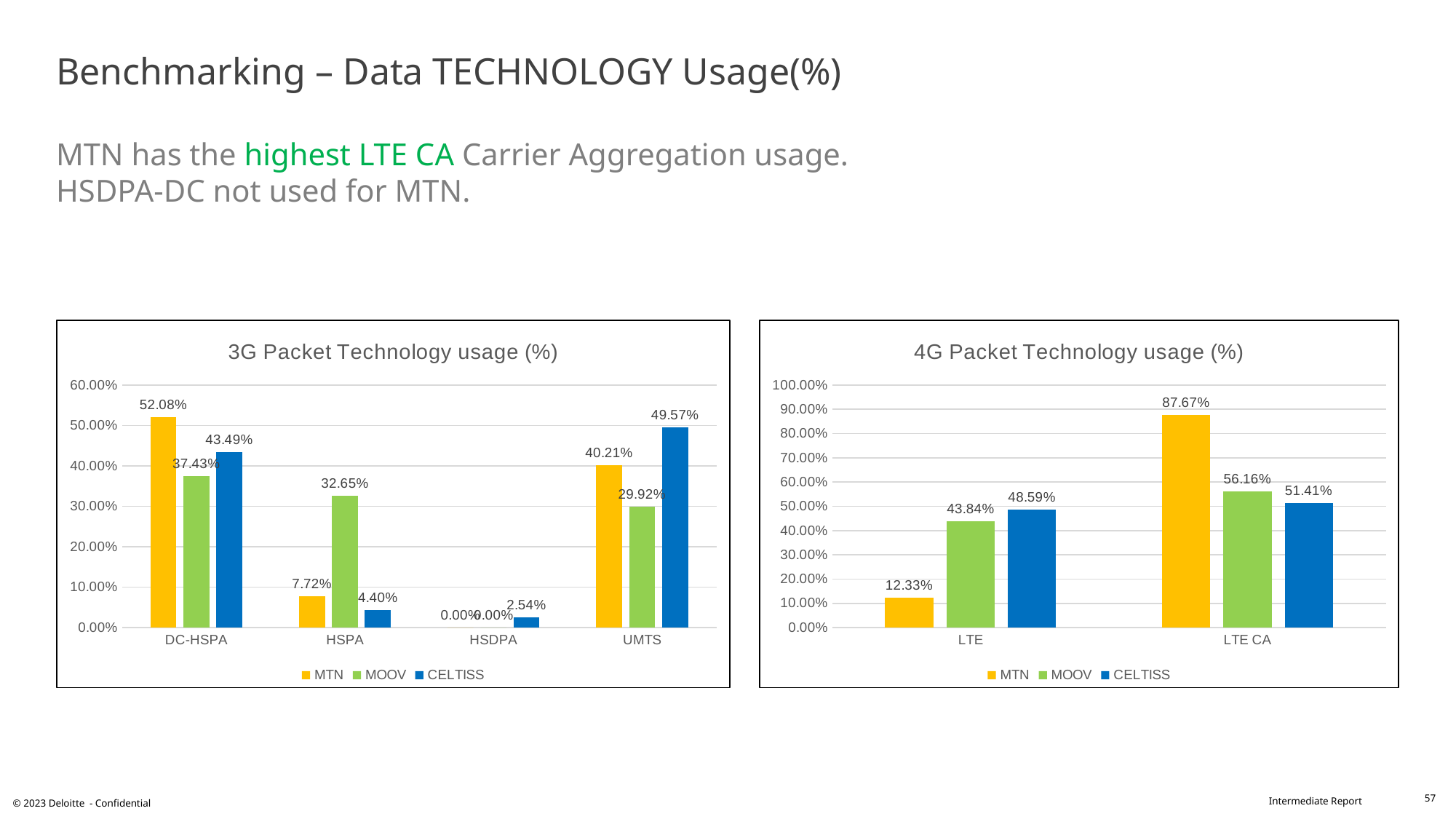
In the '3G Packet Technology usage (%)' chart, what is the value for MTN at DC-HSPA? 52.08% In the '3G Packet Technology usage (%)' chart, what is the value for CELTISS at UMTS? 49.57% In the '3G Packet Technology usage (%)' chart, what is the value for MOOV at UMTS? 29.92% In the '4G Packet Technology usage (%)' chart, what is the difference between MTN and MOOV at LTE CA? 31.51% In the '3G Packet Technology usage (%)' chart, which is larger at DC-HSPA: MOOV or CELTISS? CELTISS In the '4G Packet Technology usage (%)' chart, which operator has the lowest value at LTE? MTN In the '3G Packet Technology usage (%)' chart, how many technology categories are shown on the x axis? 4 In the '4G Packet Technology usage (%)' chart, which colour represents CELTISS? Blue What kind of chart is the '4G Packet Technology usage (%)' chart? Bar chart In the '3G Packet Technology usage (%)' chart, which operator has the highest value at HSPA? MOOV How many series does the legend of the '4G Packet Technology usage (%)' chart list? 3 In the '4G Packet Technology usage (%)' chart, what is the value for MTN at LTE CA? 87.67%